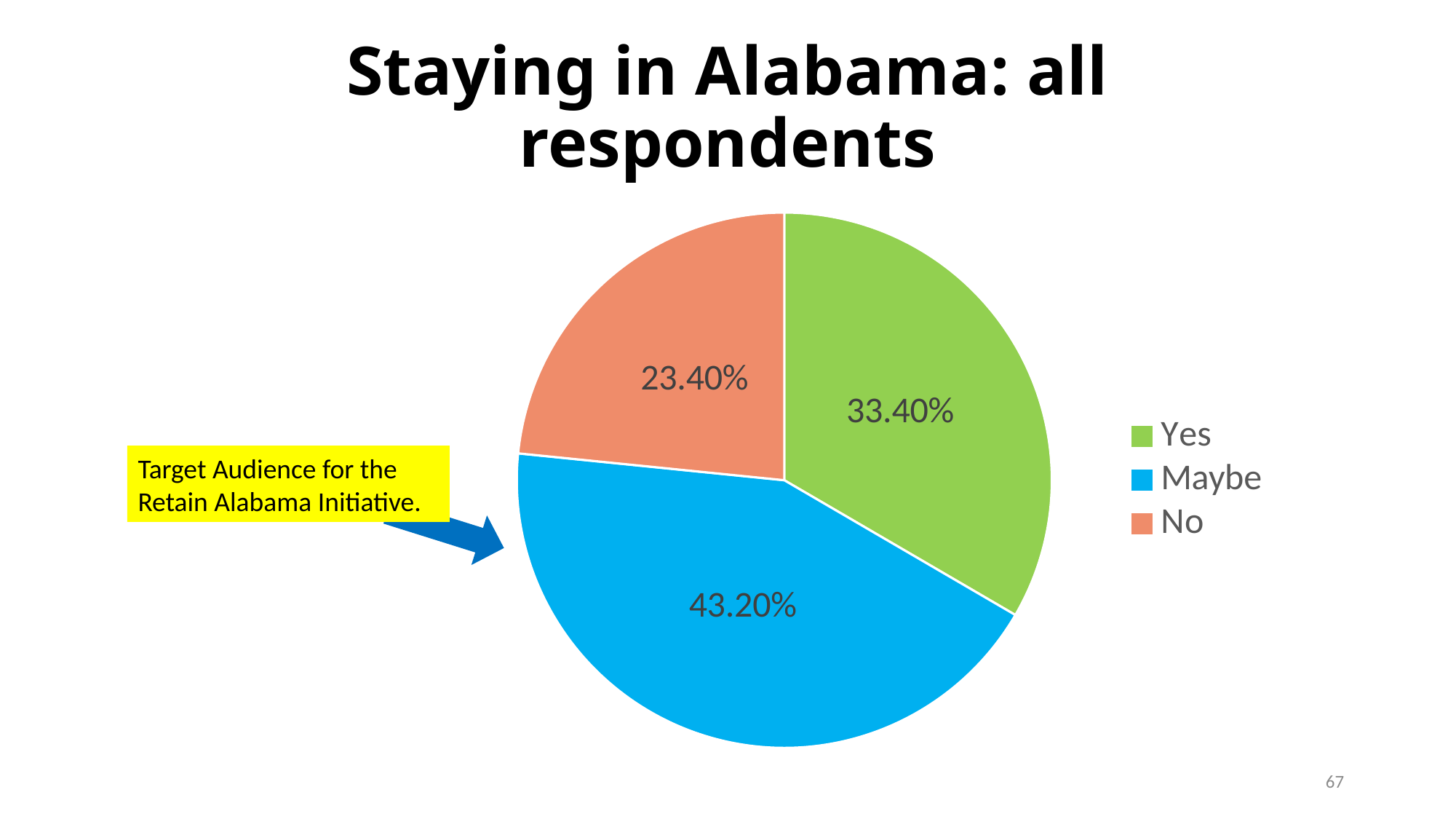
Which response has the smallest share of the pie? No How many categories does the pie chart show? 3 What is the difference in percentage points between Maybe and Yes? 9.80% What percentage of respondents answered No? 23.40% What is the difference in percentage points between Yes and No? 10.00% What percentage of respondents answered Maybe? 43.20% What kind of chart is shown on the slide? Pie chart Which is larger, the share for Yes or the share for No? Yes What percentage of respondents answered Yes? 33.40% What is the title of the slide containing the chart? Staying in Alabama: all respondents Which colour represents the Maybe slice in the legend? Blue Which response has the largest share of the pie? Maybe